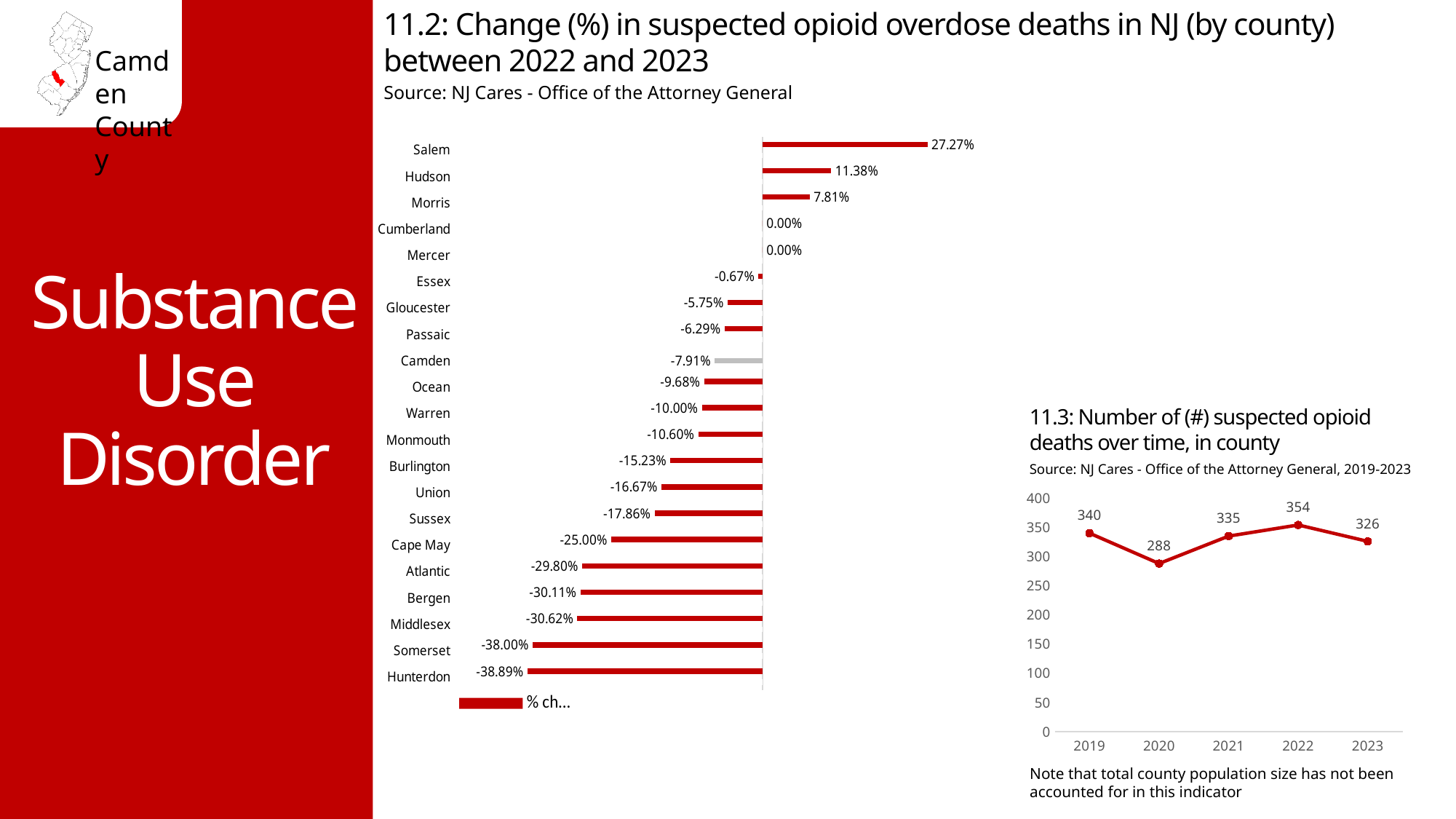
In chart 11.2, which county has the lowest percentage change? Hunterdon In chart 11.2, which has a larger percentage change, Salem or Morris? Salem In chart 11.3, which year had the highest number of suspected opioid deaths? 2022 In chart 11.2, how many counties are shown? 21 In chart 11.2, what is the percentage change in suspected opioid overdose deaths for Camden? -7.91% In chart 11.3, which year had the lowest number of suspected opioid deaths? 2020 In chart 11.2, what is the percentage change for Hudson? 11.38% In chart 11.2, which county has the highest percentage change? Salem What kind of chart is chart 11.2? Bar chart What kind of chart is chart 11.3? Line chart In chart 11.3, how many suspected opioid deaths were there in 2020? 288 In chart 11.3, what is the difference in suspected opioid deaths between 2022 and 2023? 28